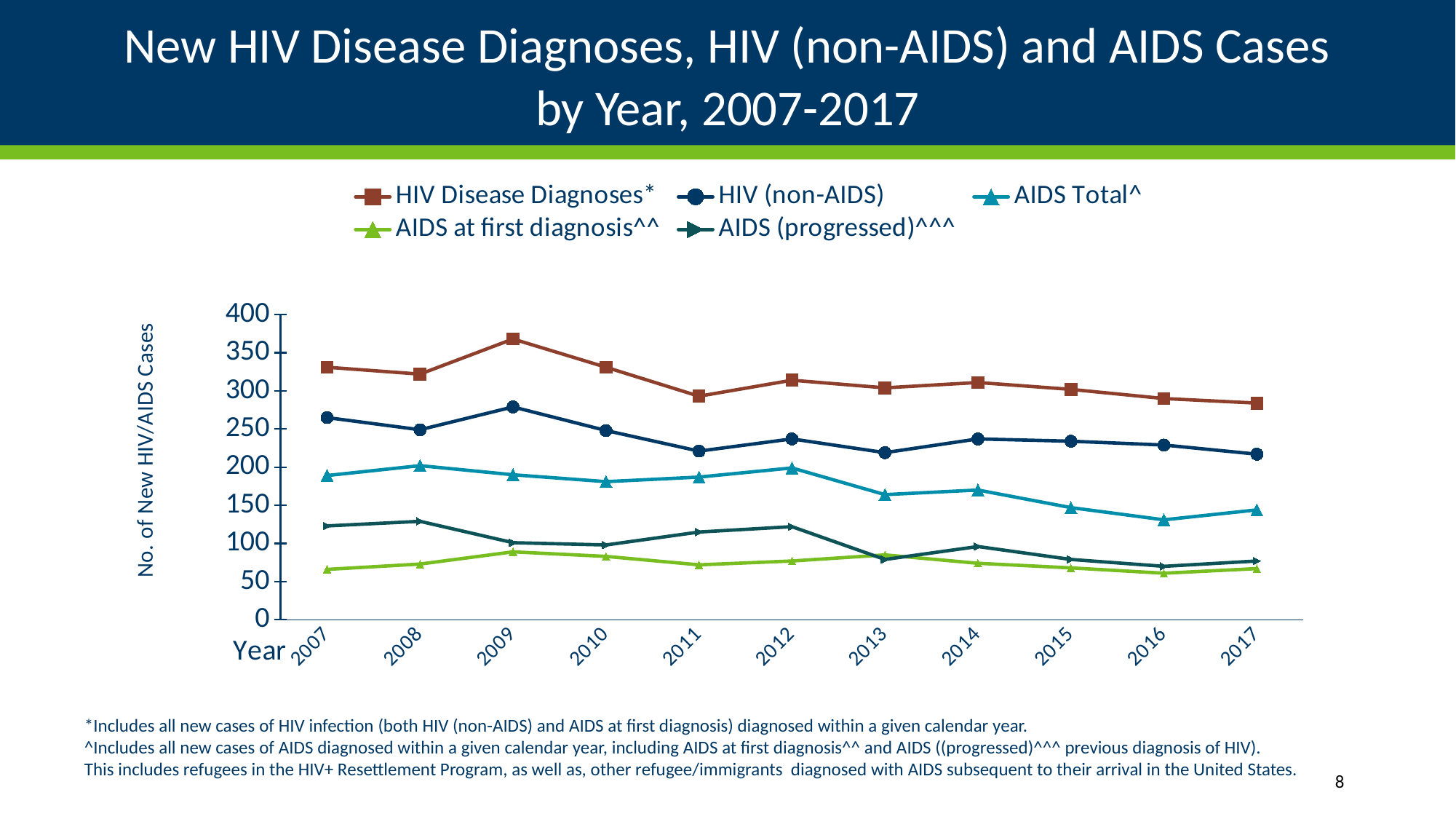
In which year is the AIDS Total^ series lowest? 2016 Is the value for HIV Disease Diagnoses* in 2009 greater or less than 350? greater In which year is the HIV Disease Diagnoses* series highest? 2009 Is the value for AIDS (progressed)^^^ in 2012 greater or less than 100? greater In which year is the HIV (non-AIDS) series highest? 2009 Is the value for AIDS Total^ in 2016 greater or less than 150? less What kind of chart is shown on the slide? line chart How many series does the legend list? 5 Does the HIV Disease Diagnoses* series rise or fall from 2014 to 2017? fall In 2007, which is larger: AIDS (progressed)^^^ or AIDS at first diagnosis^^? AIDS (progressed)^^^ How many years are plotted along the x axis? 11